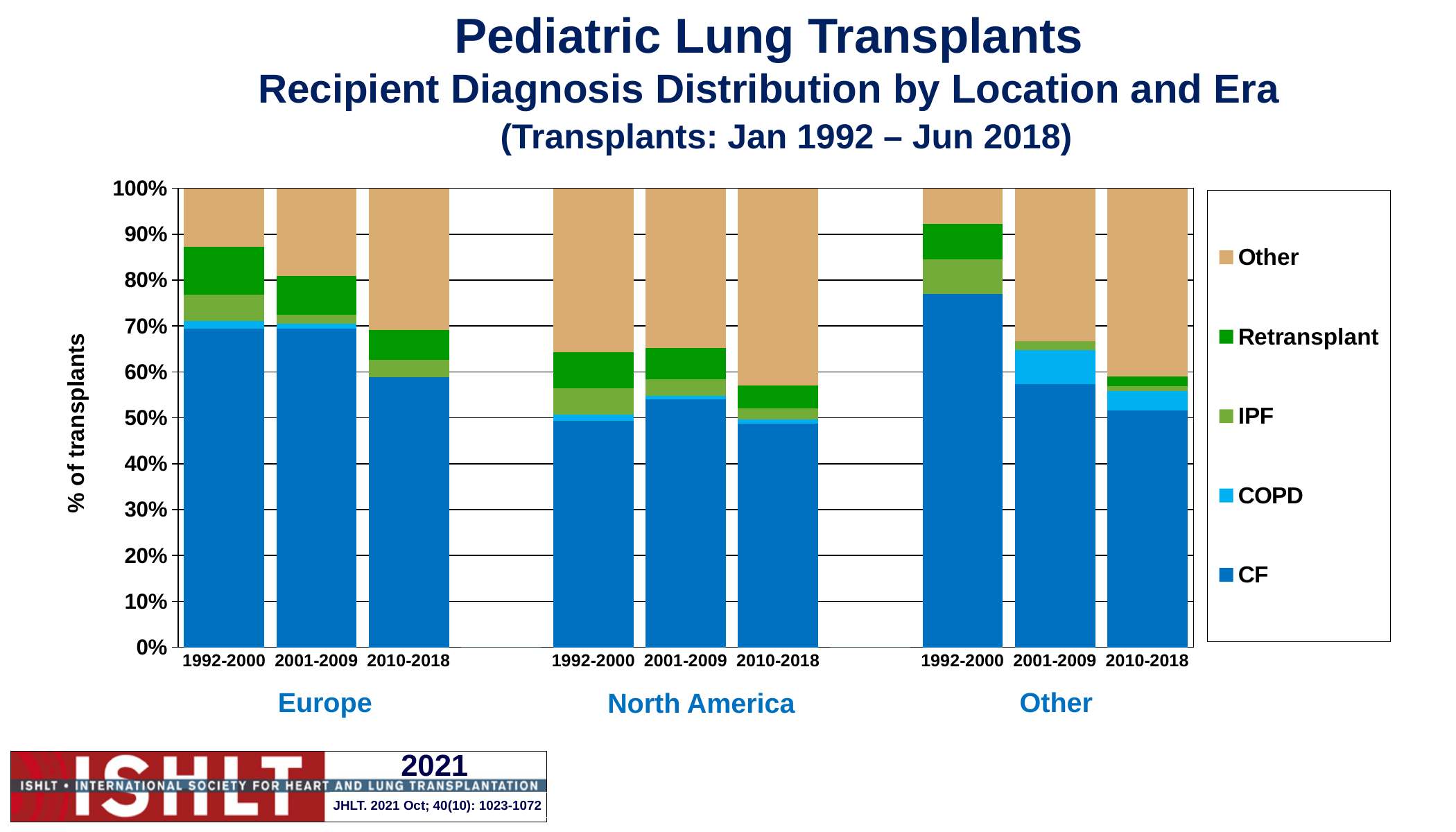
Which has the larger CF share: Europe 1992-2000 or North America 1992-2000? Europe 1992-2000 Is the CF share for North America 2010-2018 greater or less than 60%? less Is the CF share for Europe 2010-2018 greater or less than 50%? greater Is the CF share for Europe 1992-2000 greater or less than 60%? greater Which diagnosis is shown at the bottom of each stacked bar? CF How many bars are plotted in the chart? 9 Does the CF share in Europe rise or fall across the eras from 1992-2000 to 2010-2018? fall Which bar has the largest CF share? Other 1992-2000 Which three locations are shown along the x axis? Europe, North America, Other What kind of chart is shown on the slide? Stacked bar chart How many series does the legend list? 5